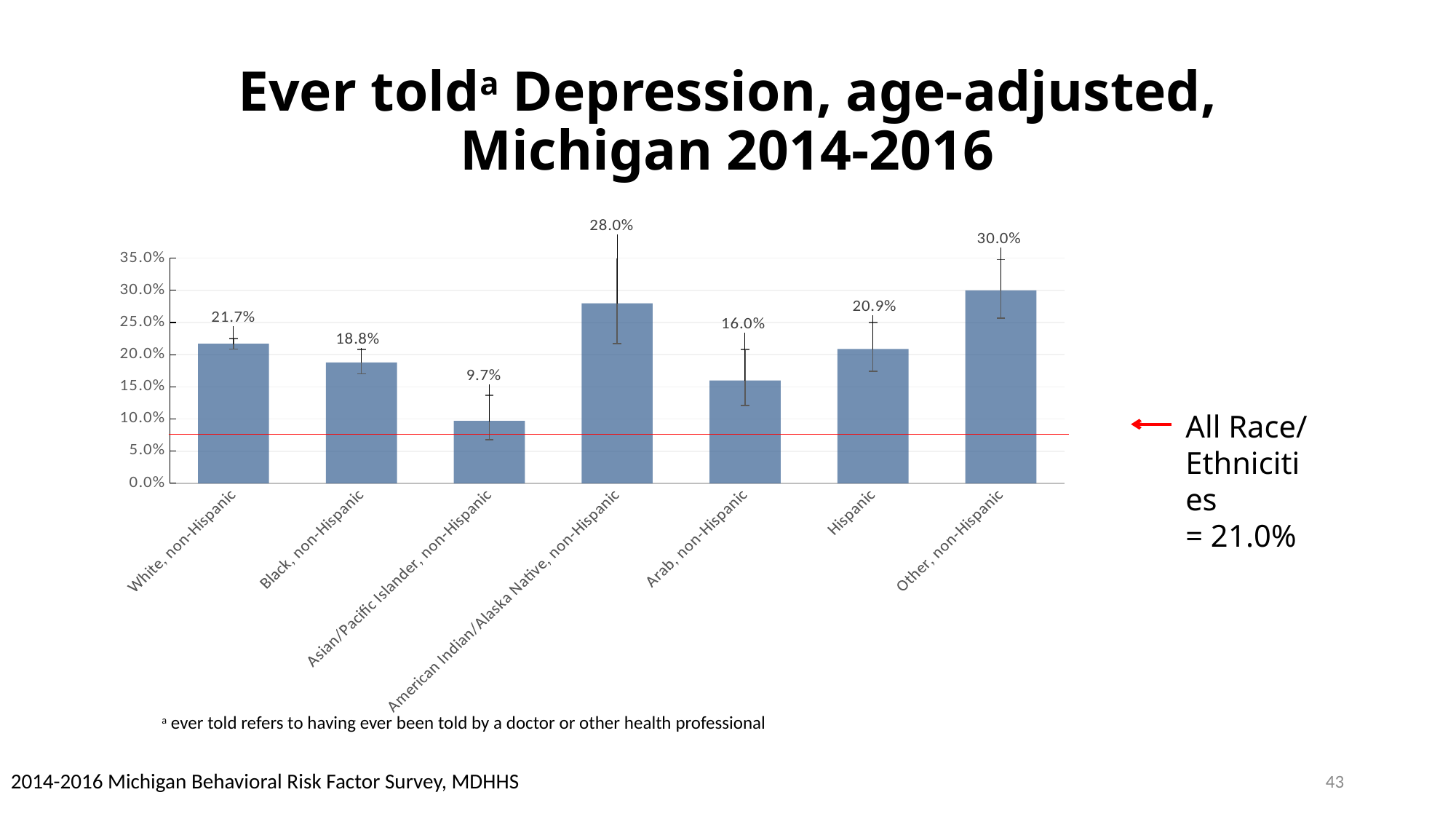
What kind of chart is shown on the slide? Bar chart What is the value for White, non-Hispanic? 21.7% Which is larger, the value for Black, non-Hispanic or the value for Arab, non-Hispanic? Black, non-Hispanic Which category has the lowest value? Asian/Pacific Islander, non-Hispanic How many categories are shown on the chart? 7 What is the value for Asian/Pacific Islander, non-Hispanic? 9.7% What is the value for All Race/Ethnicities indicated by the red line? 21.0% What is the difference between the values for Other, non-Hispanic and American Indian/Alaska Native, non-Hispanic? 2.0% Which category has the highest value? Other, non-Hispanic What is the title of the chart? Ever told Depression, age-adjusted, Michigan 2014-2016 What is the value for Hispanic? 20.9% What is the value for Arab, non-Hispanic? 16.0%